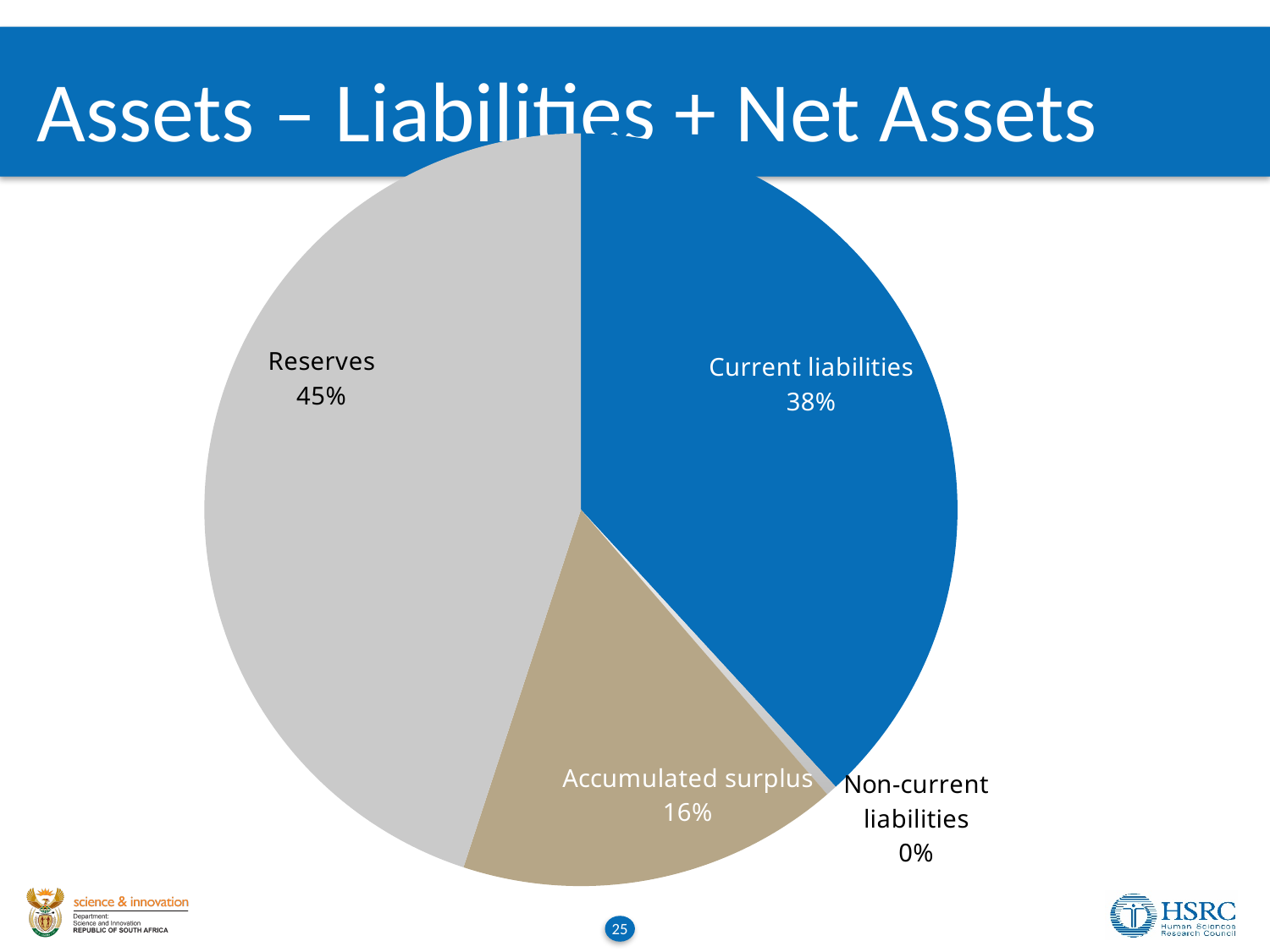
What share of the pie does Non-current liabilities represent? 0% Which category has the smallest slice of the pie? Non-current liabilities How many categories are shown in the pie chart? 4 What is the difference in percentage points between Current liabilities and Accumulated surplus? 22 Which is larger, Accumulated surplus or Current liabilities? Current liabilities What share of the pie does Reserves represent? 45% Which category has the largest slice of the pie? Reserves What kind of chart is shown on the slide? Pie chart What share of the pie does Current liabilities represent? 38% What is the difference in percentage points between Reserves and Current liabilities? 7 What share of the pie does Accumulated surplus represent? 16% What is the title of the slide containing the chart? Assets – Liabilities + Net Assets